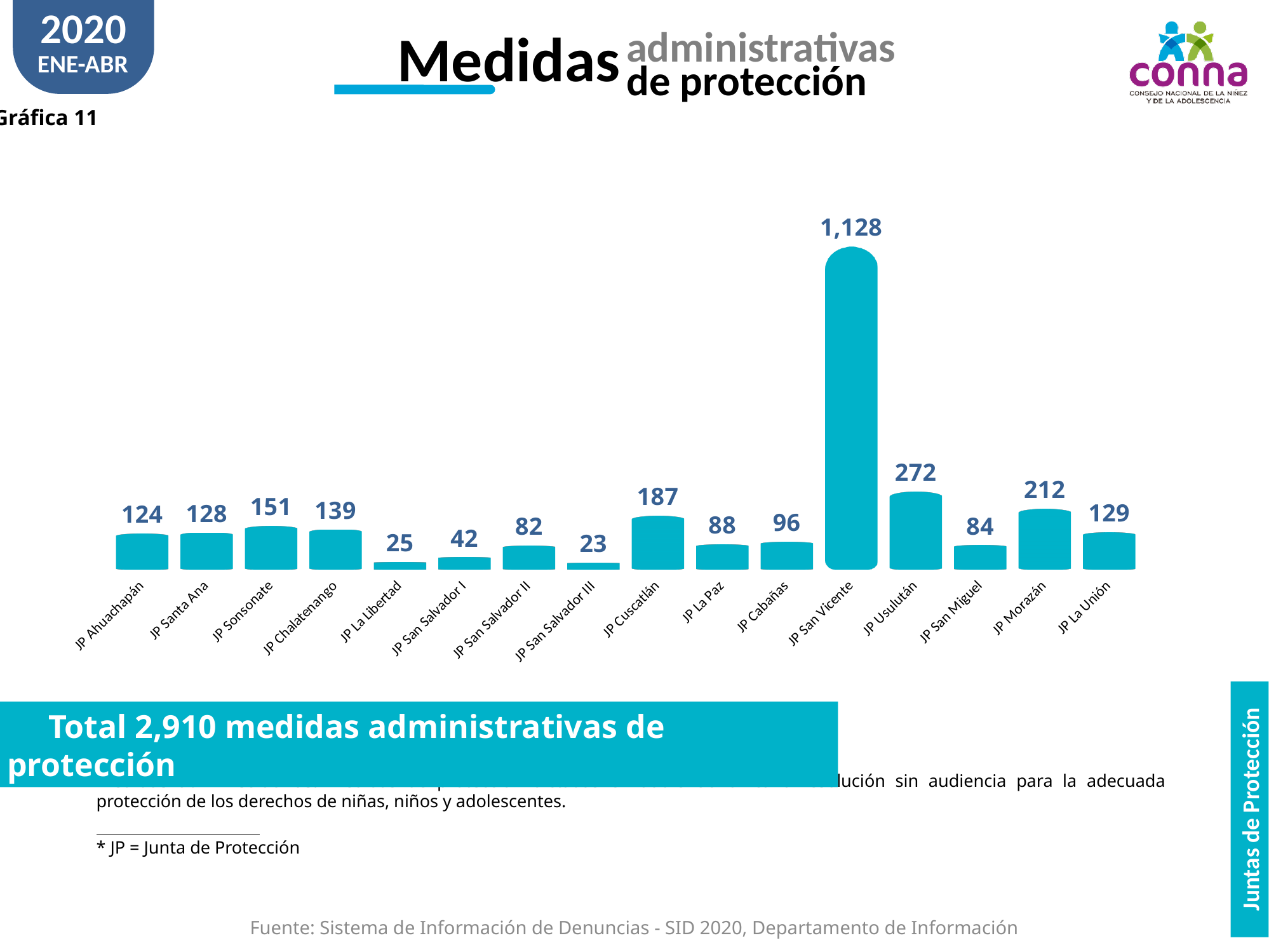
What is the value for JP Cuscatlán? 187 What kind of chart is shown on the slide? Bar chart What is the value for JP La Libertad? 25 What is the difference between the values for JP San Vicente and JP Usulután? 856 What is the difference between the values for JP Usulután and JP Morazán? 60 What is the value for JP San Vicente? 1,128 Which is larger, the value for JP Sonsonate or the value for JP Chalatenango? JP Sonsonate What total number of medidas administrativas de protección is stated on the slide? 2,910 Which category has the highest value? JP San Vicente Which category has the lowest value? JP San Salvador III How many categories are shown in the chart? 16 What is the value for JP Morazán? 212